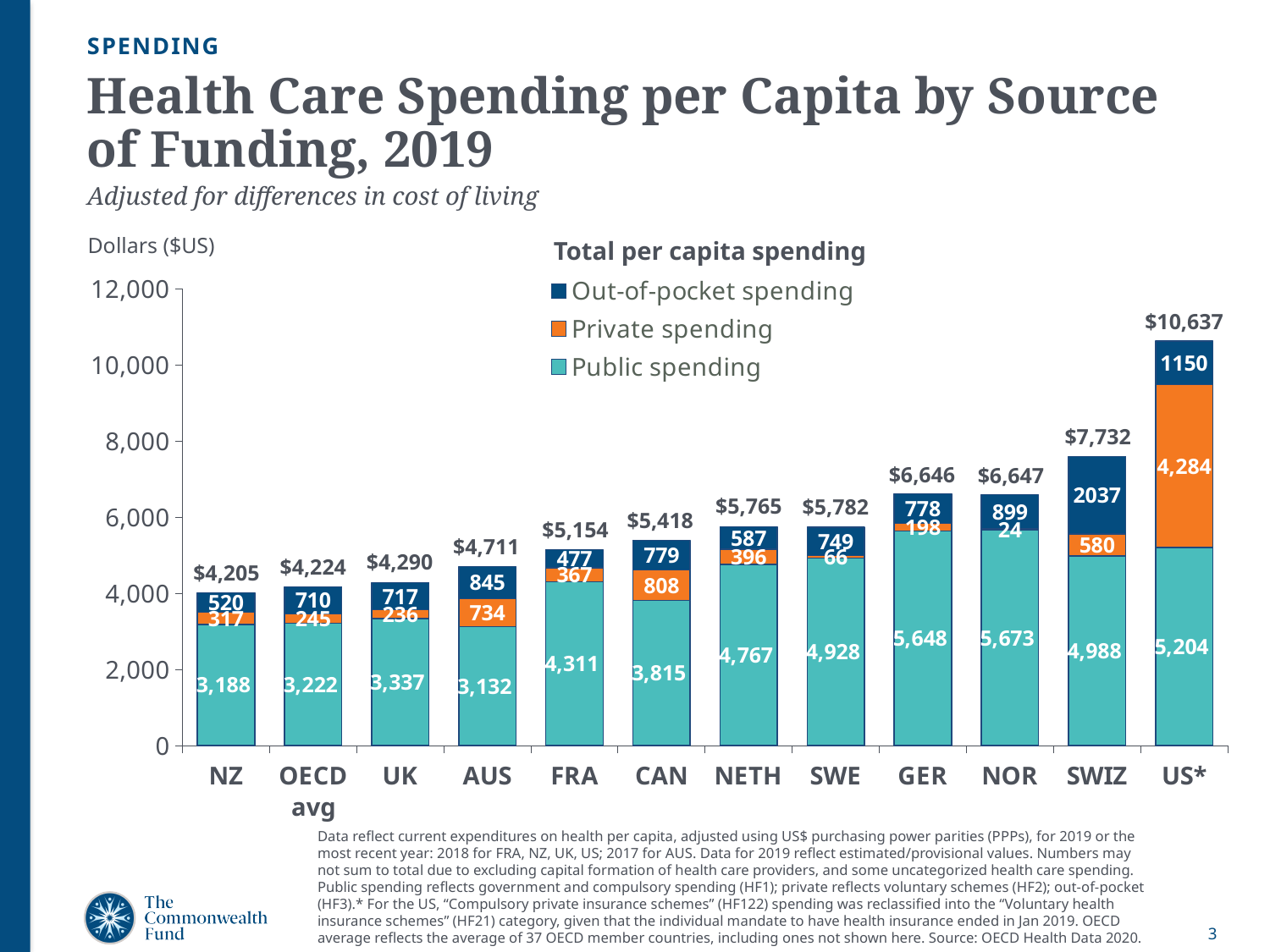
Which country has the lowest total per capita spending? NZ Which country has the highest total per capita spending? US* What is the total per capita health care spending for Canada (CAN)? $5,418 What is the out-of-pocket spending value for Switzerland (SWIZ)? 2037 What is the difference in total per capita spending between the US* and Switzerland (SWIZ)? $2,905 How many series does the legend list? 3 What is the public spending value for Germany (GER)? 5,648 How many countries or categories are shown on the x axis? 12 What is the private spending value for the US*? 4,284 Which has higher public spending, Sweden (SWE) or the Netherlands (NETH)? SWE Is the total per capita spending for France (FRA) greater or less than 6,000? less What kind of chart is shown on the slide? Stacked bar chart